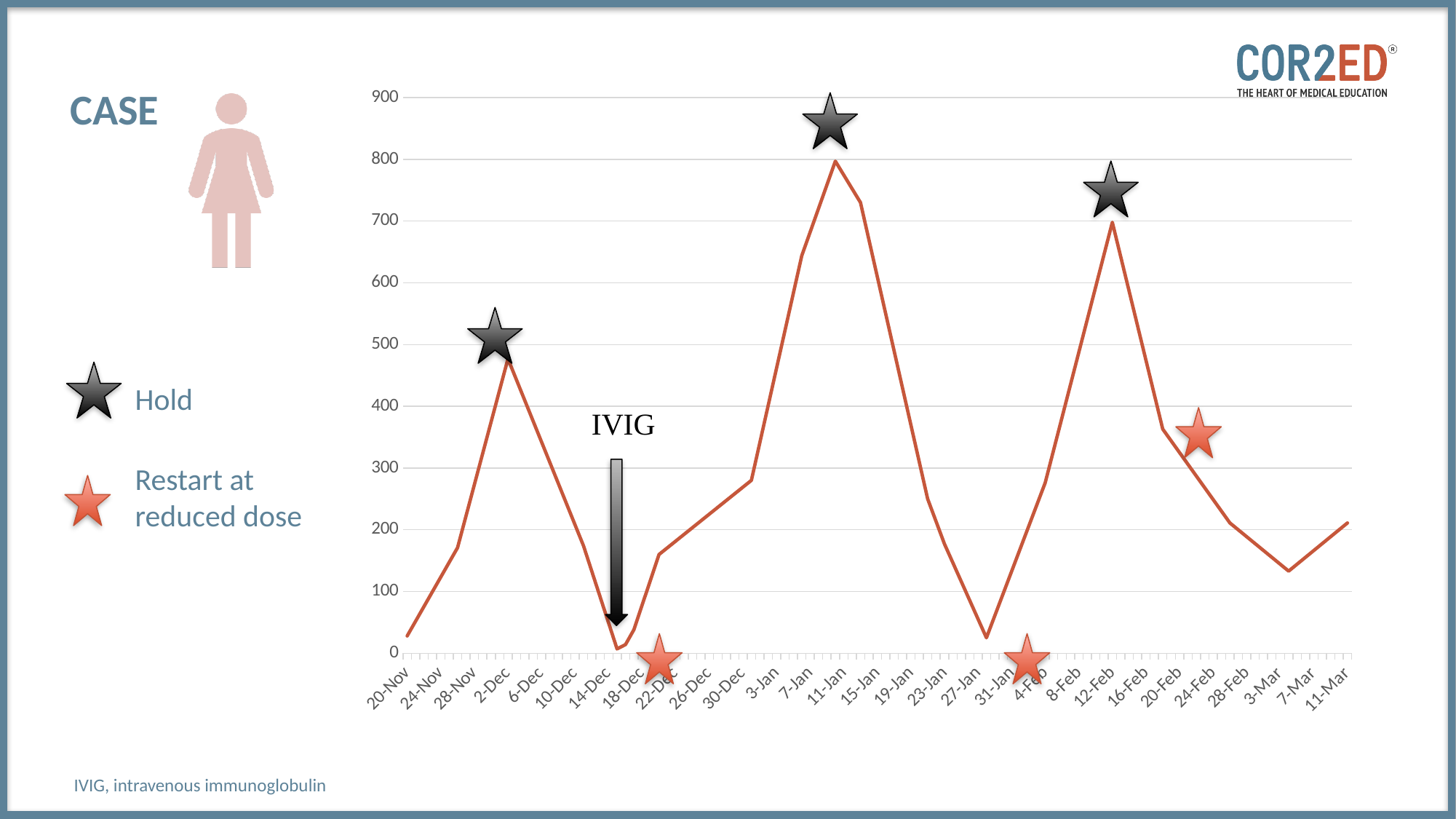
Is the value for 20-Nov greater or less than 100? less What label is written above the arrow pointing down to the line in December? IVIG Does the line rise or fall from 12-Feb to 20-Feb? fall What kind of chart is shown on the slide? line chart Which of the three peaks of the line is the highest: the first (December), the second (January) or the third (February)? the second (January) Is the highest value reached by the line greater or less than 700? greater Which is larger, the value for 20-Nov or the value for 11-Mar? 11-Mar Does the line rise or fall from 20-Nov to 28-Nov? rise According to the legend, what does the black star on the chart represent? Hold How many date labels are shown along the x axis of the chart? 29 Is the first peak of the line (in early December) greater or less than 500? less